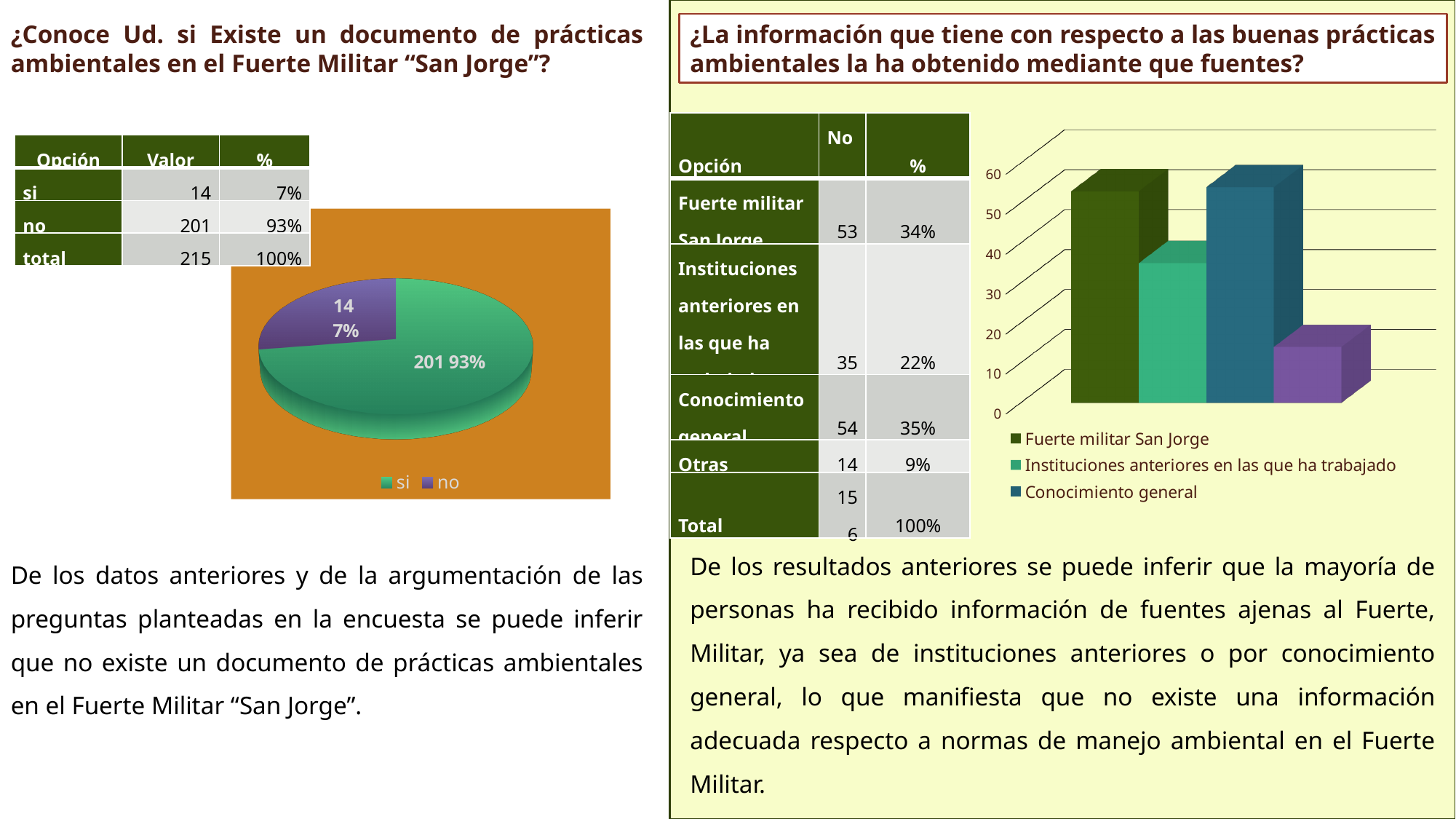
What type of chart is shown on the left side of the slide? pie chart In the bar chart on the right, is the value for Instituciones anteriores en las que ha trabajado greater or less than 20? greater How many entries does the legend of the pie chart on the left list? 2 How many entries does the legend of the bar chart on the right list? 3 In the pie chart on the left, what percentage is shown on the purple slice? 7% What type of chart is shown on the right side of the slide? bar chart In the pie chart on the left, what value is shown on the purple slice? 14 In the bar chart on the right, is the value for Fuerte militar San Jorge greater or less than 40? greater In the bar chart on the right, which is larger, the bar for Conocimiento general or the bar for Instituciones anteriores en las que ha trabajado? Conocimiento general In the pie chart on the left, which colour slice is larger, green or purple? green How many bars are plotted in the bar chart on the right? 4 In the pie chart on the left, what percentage is shown on the green slice? 93%